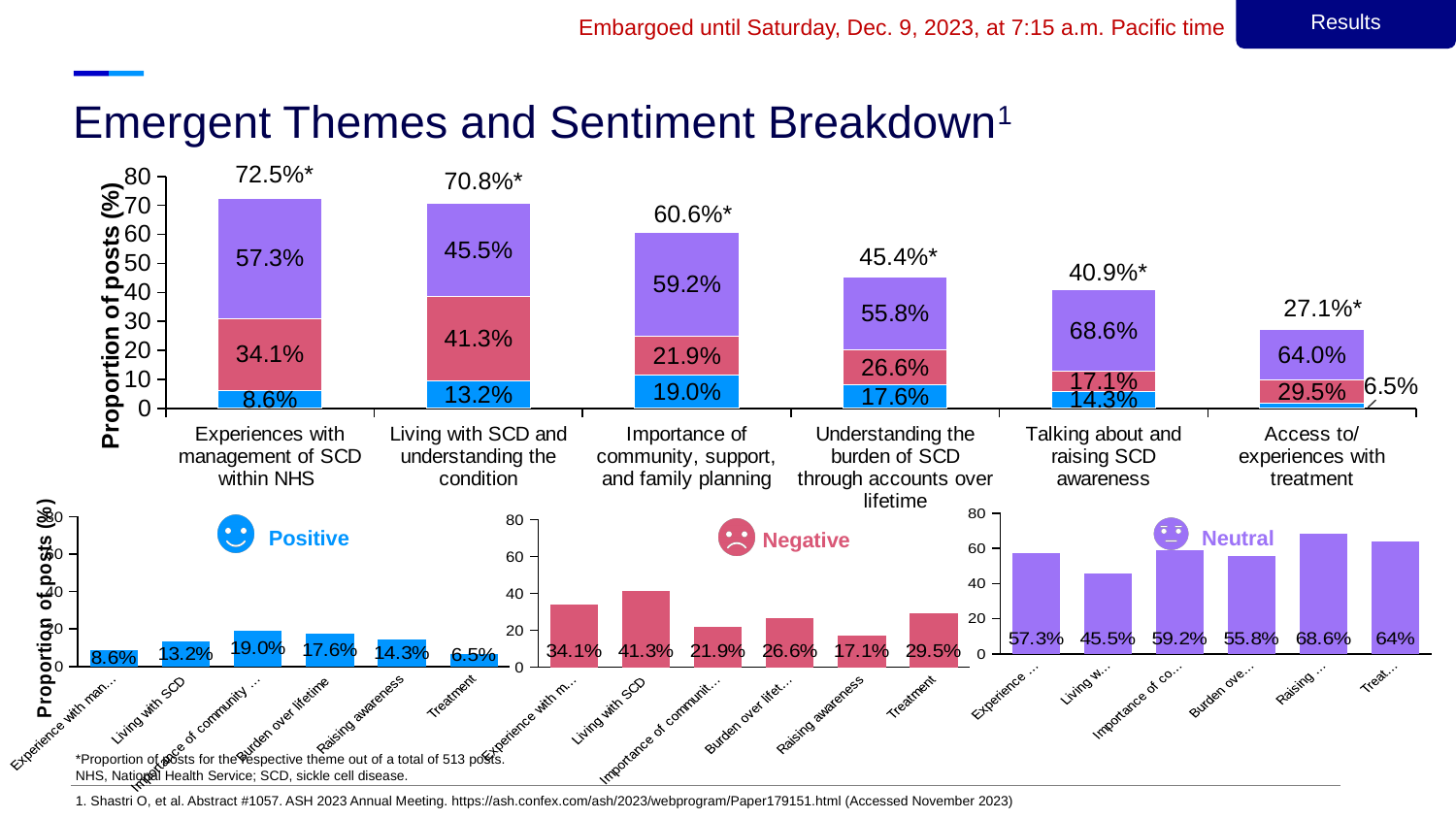
In the main stacked bar chart, what is the value of the purple (neutral) segment for 'Talking about and raising SCD awareness'? 68.6% In the Negative chart, what is the value for 'Living with SCD'? 41.3% In the Negative chart, which category has the highest value? Living with SCD In the Positive chart, what is the difference between the values for 'Living with SCD' and 'Treatment'? 6.7 percentage points What kind of chart is the main chart at the top of the slide? Stacked bar chart In the main stacked bar chart, what proportion of posts is labelled above the bar for 'Experiences with management of SCD within NHS'? 72.5%* How many themes are shown in the main stacked bar chart? 6 In the main stacked bar chart, do the overall proportions of posts rise or fall from left to right? Fall In the main stacked bar chart, which has the larger red (negative) segment: 'Living with SCD and understanding the condition' or 'Experiences with management of SCD within NHS'? Living with SCD and understanding the condition In the main stacked bar chart, which theme has the highest overall proportion of posts? Experiences with management of SCD within NHS In the main stacked bar chart, which theme has the lowest overall proportion of posts? Access to/experiences with treatment In the Positive chart, what is the value for 'Treatment'? 6.5%